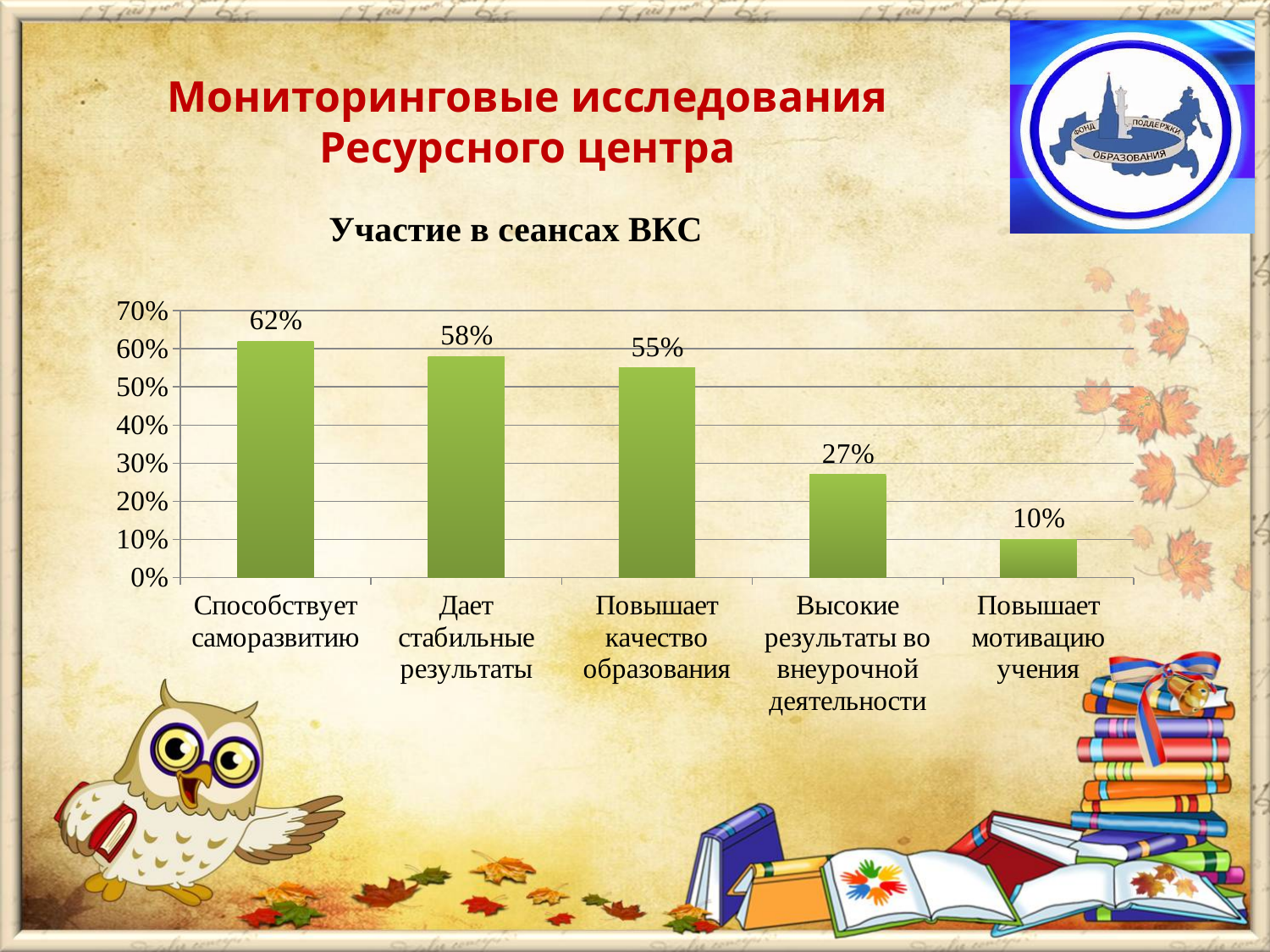
How many categories are shown in the chart? 5 Which is larger: «Дает стабильные результаты» or «Высокие результаты во внеурочной деятельности»? Дает стабильные результаты What kind of chart is shown on the slide? bar chart Which category has the highest value? Способствует саморазвитию What is the value for «Способствует саморазвитию»? 62% What is the difference between «Способствует саморазвитию» and «Повышает мотивацию учения»? 52% What is the value for «Повышает мотивацию учения»? 10% What is the difference between «Дает стабильные результаты» and «Повышает качество образования»? 3% What is the value for «Высокие результаты во внеурочной деятельности»? 27% Which category has the lowest value? Повышает мотивацию учения What is the title of the chart? Участие в сеансах ВКС Is the value for «Повышает качество образования» greater or less than 50%? greater